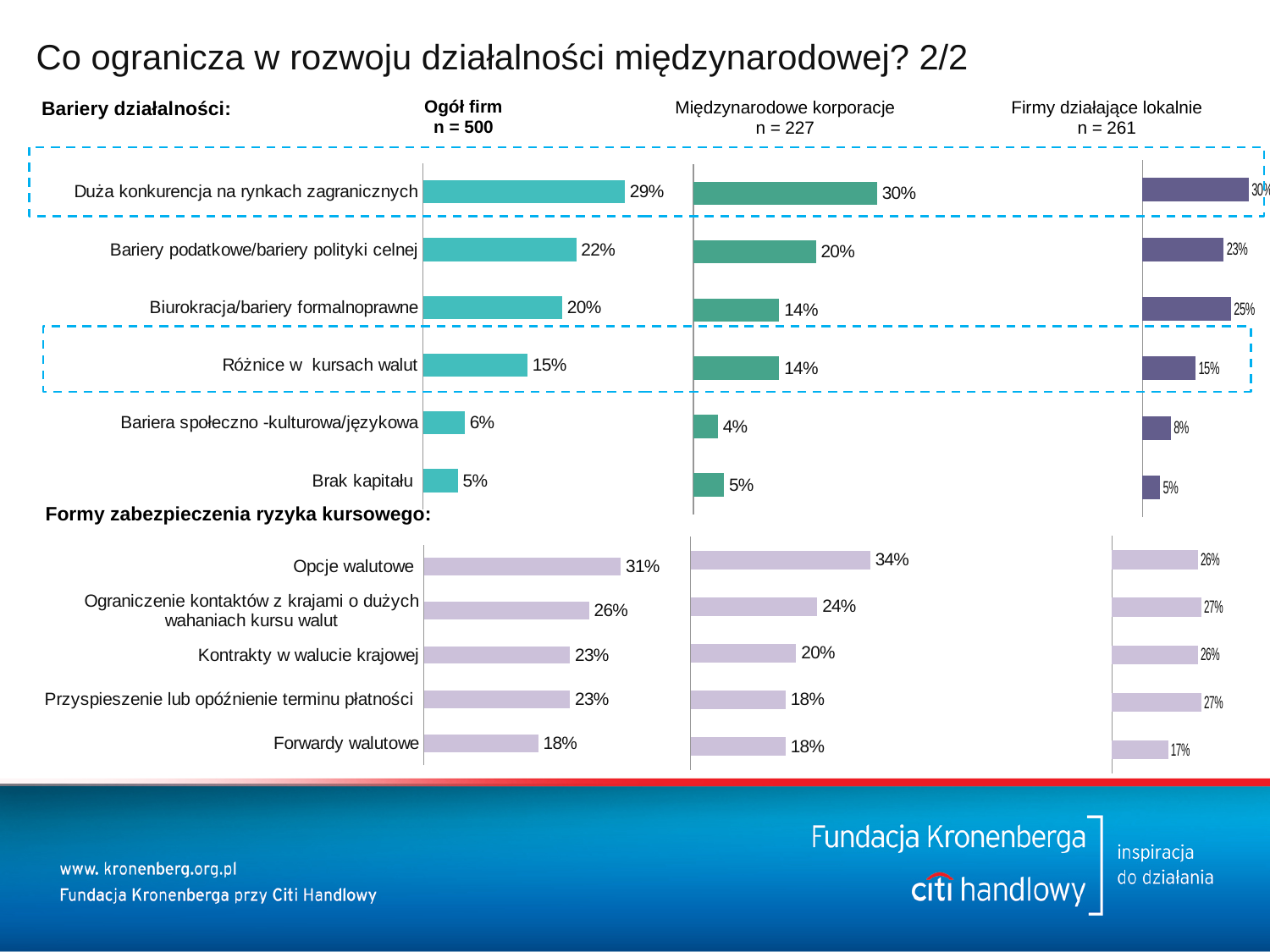
How many forms are listed in the 'Formy zabezpieczenia ryzyka kursowego' chart for 'Firmy działające lokalnie'? 5 In the 'Bariery działalności' charts, is the value for 'Bariera społeczno-kulturowa/językowa' larger for 'Ogół firm' or for 'Firmy działające lokalnie'? Firmy działające lokalnie In the 'Formy zabezpieczenia ryzyka kursowego' chart for 'Ogół firm', what is the difference between 'Opcje walutowe' and 'Forwardy walutowe'? 13% In the 'Bariery działalności' chart for 'Ogół firm', which barrier has the lowest value? Brak kapitału How many barriers are listed in the 'Bariery działalności' chart for 'Ogół firm'? 6 What kind of chart is used for 'Bariery działalności' in the 'Ogół firm' column? Bar chart In the 'Bariery działalności' chart for 'Międzynarodowe korporacje' (n = 227), what is the value for 'Biurokracja/bariery formalnoprawne'? 14% What is the sample size (n) shown for the 'Firmy działające lokalnie' column? n = 261 In the 'Formy zabezpieczenia ryzyka kursowego' chart for 'Międzynarodowe korporacje', which form has the highest value? Opcje walutowe In the 'Formy zabezpieczenia ryzyka kursowego' chart for 'Międzynarodowe korporacje', what is the value for 'Kontrakty w walucie krajowej'? 20% In the 'Bariery działalności' chart for 'Firmy działające lokalnie' (n = 261), what is the value for 'Bariery podatkowe/bariery polityki celnej'? 23% In the 'Bariery działalności' chart for 'Ogół firm' (n = 500), what is the value for 'Duża konkurencja na rynkach zagranicznych'? 29%